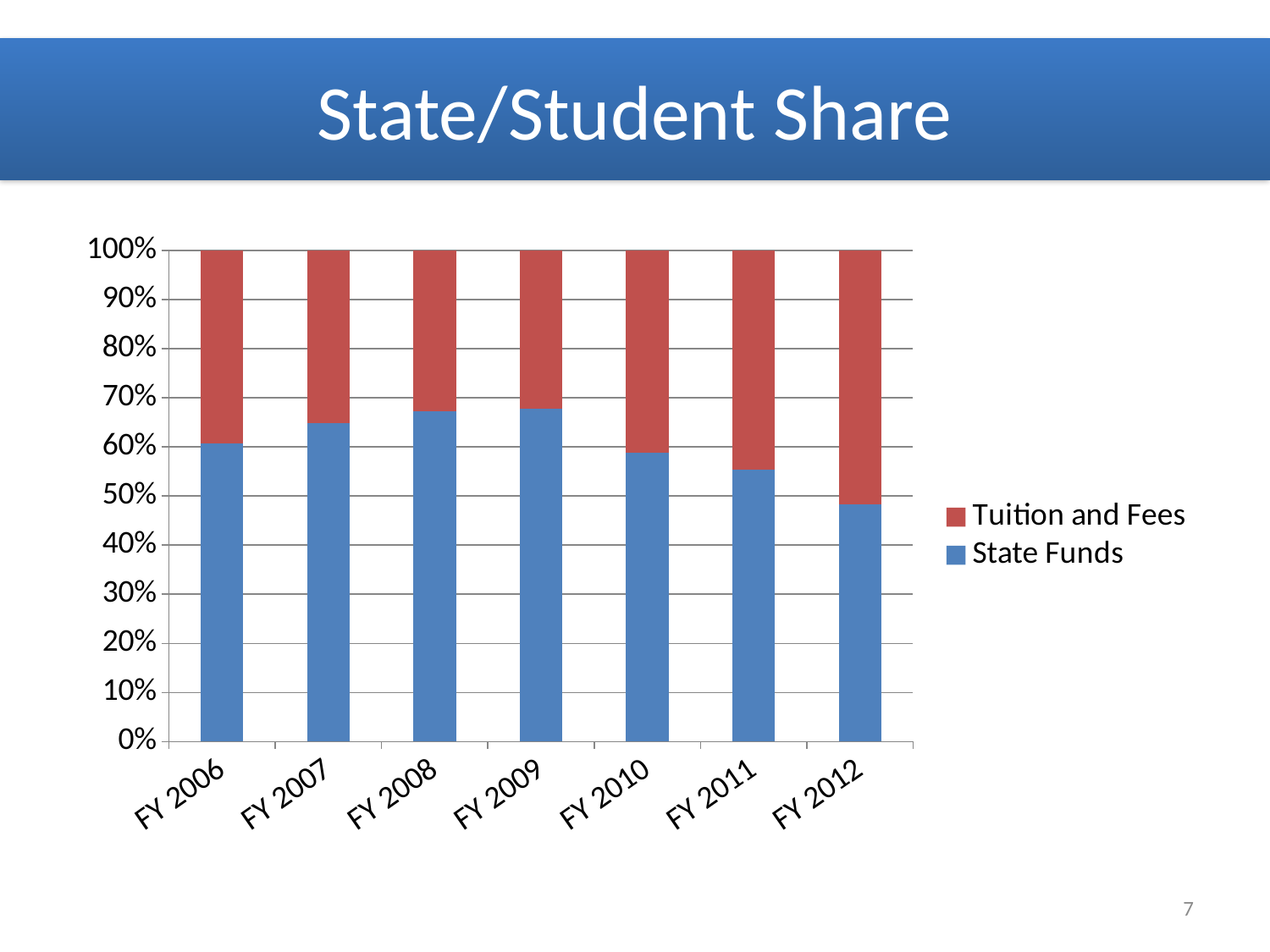
In which fiscal year is the Tuition and Fees share highest? FY 2012 What kind of chart is shown on the slide? Stacked bar chart Is the State Funds share for FY 2011 greater or less than 50%? greater Is the State Funds share for FY 2012 greater or less than 50%? less Which fiscal year has a larger State Funds share, FY 2008 or FY 2012? FY 2008 How many series does the legend list? 2 From FY 2009 to FY 2012, does the State Funds share rise or fall? fall Which series is shown in blue? State Funds How many fiscal years are shown on the x axis? 7 Is the State Funds share for FY 2008 greater or less than 60%? greater In which fiscal year is the State Funds share lowest? FY 2012 What is the title of the slide containing the chart? State/Student Share